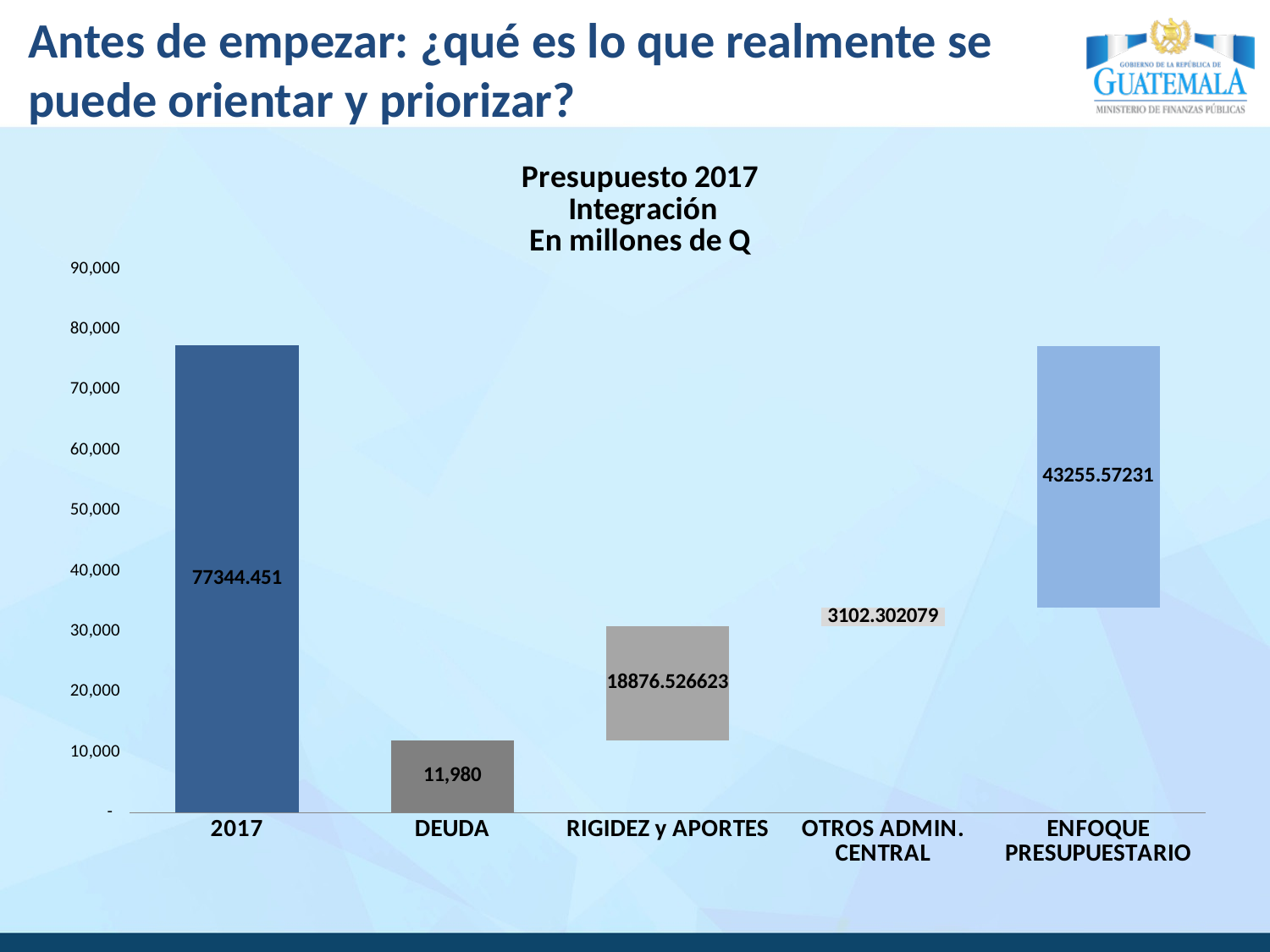
In what units are the values in the chart expressed, according to the chart title? Millones de Q Which category has the lowest value? OTROS ADMIN. CENTRAL Which category has the highest value? 2017 What is the value shown for RIGIDEZ y APORTES? 18876.526623 How many categories are shown on the x axis? 5 Which is larger, the value for DEUDA or the value for RIGIDEZ y APORTES? RIGIDEZ y APORTES What is the value shown for DEUDA? 11,980 What is the value shown for OTROS ADMIN. CENTRAL? 3102.302079 What is the value shown for the 2017 bar? 77344.451 What is the value shown for ENFOQUE PRESUPUESTARIO? 43255.57231 What kind of chart is shown on the slide? Bar chart What is the difference between the value for RIGIDEZ y APORTES and the value for DEUDA? 6896.526623